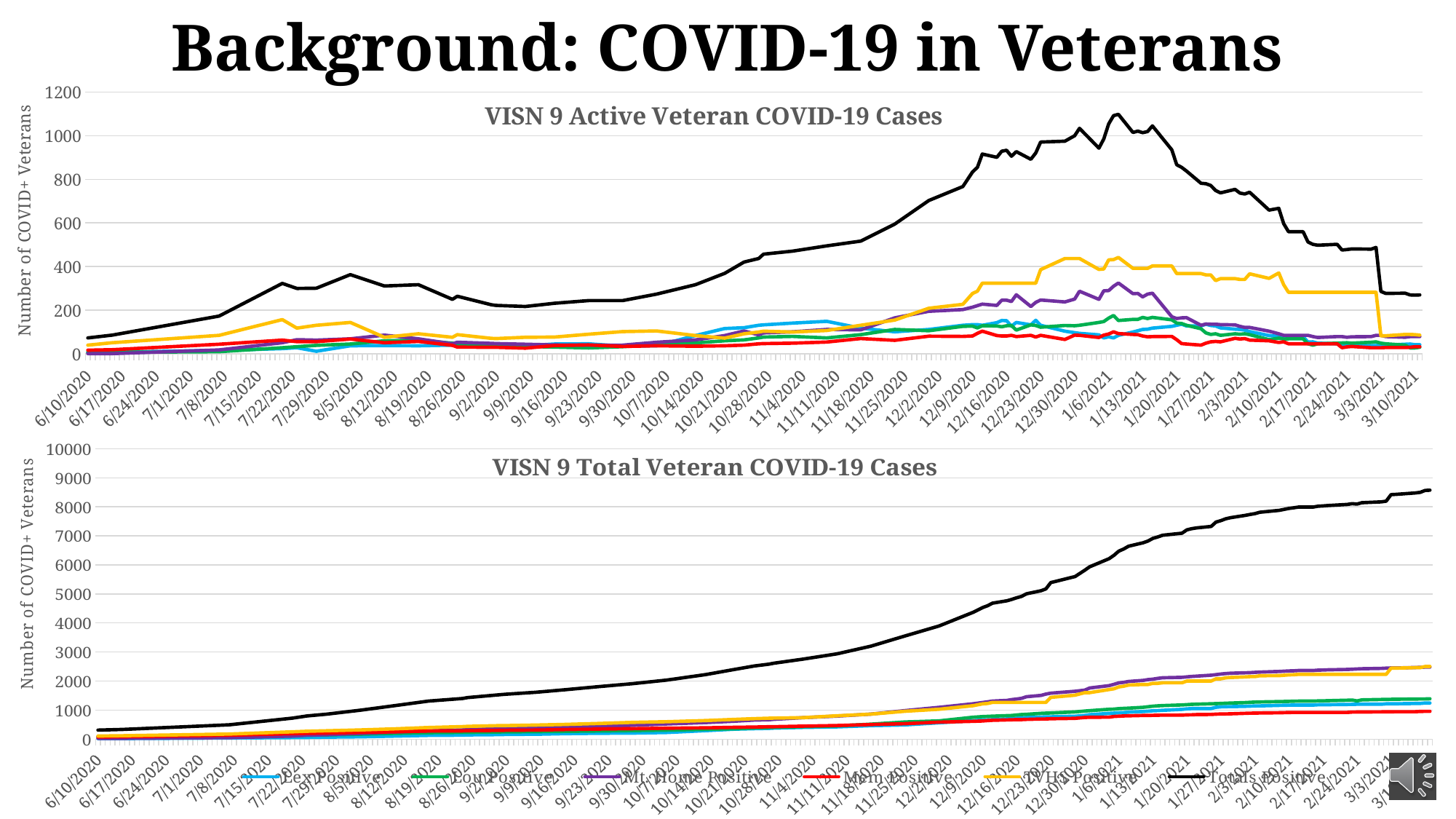
What is the title of the bottom chart? VISN 9 Total Veteran COVID-19 Cases In the bottom chart, at the end of the series, which is larger: Mt. Home Positive or Mem Positive? Mt. Home Positive In the top chart, is the Totals Positive value on 3/10/2021 greater or less than 400? less In the bottom chart, is the Mt. Home Positive value at the end of the series greater or less than 2000? greater In the bottom chart, does the Totals Positive line rise or fall from 6/10/2020 to 3/10/2021? rises In the top chart, is the peak value of the TVHS Positive line greater or less than 300? greater What kind of chart is the top chart, 'VISN 9 Active Veteran COVID-19 Cases'? line chart What colour is the Totals Positive line in the legend? black How many series does the legend at the bottom of the slide list? 6